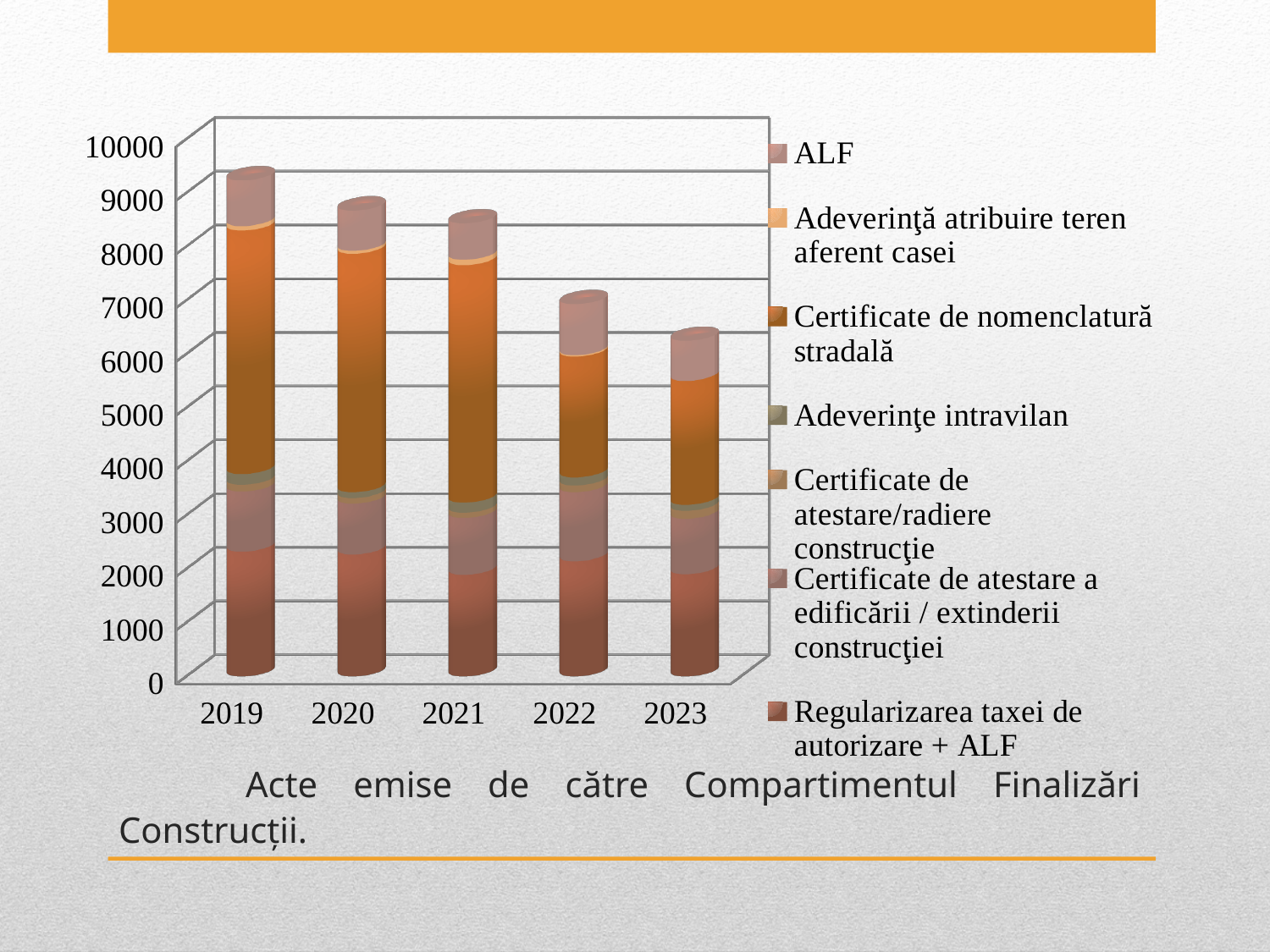
Which year has the tallest stacked bar? 2019 Do the total bar heights rise or fall from 2019 to 2023? Fall Which series is listed first (at the top) in the chart's legend? ALF Is the total for 2020 greater or less than 8000? greater Is the total for 2023 greater or less than 7000? less Which year has the shortest stacked bar? 2023 What kind of chart is shown on the slide? Stacked bar chart How many series does the chart's legend list? 7 How many years are shown on the x axis of the chart? 5 Is the total for 2019 greater or less than 9000? greater Which series is listed last (at the bottom) in the chart's legend? Regularizarea taxei de autorizare + ALF